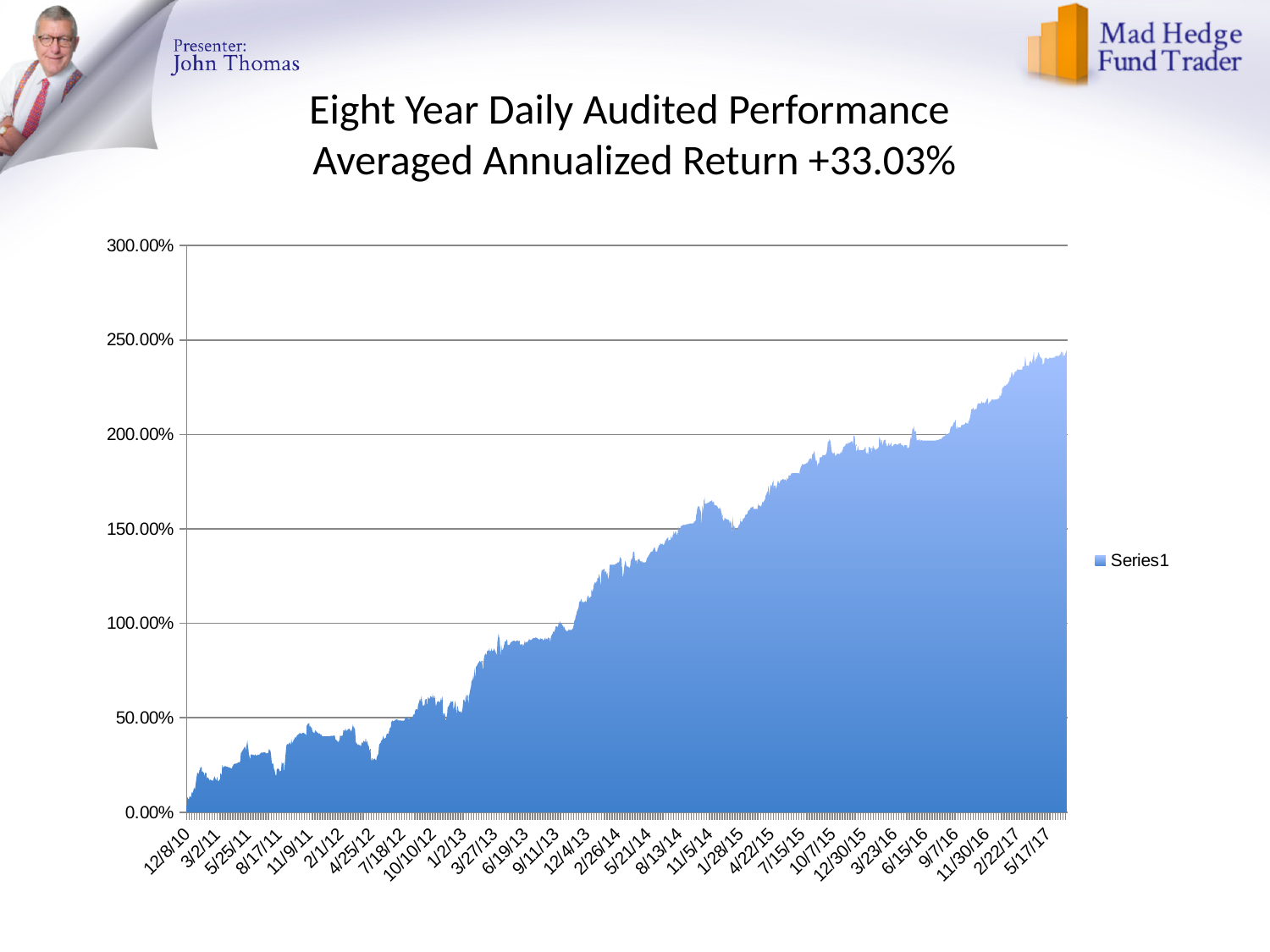
Is the value at 11/5/14 greater or less than 150.00%? greater What is the name of the series shown in the legend? Series1 Is the value at 10/7/15 greater or less than 200.00%? less Is the value at 5/17/17 greater or less than 200.00%? greater What kind of chart is shown on the slide? area chart How many series does the legend list? 1 Do the values generally rise or fall from left to right along the x axis? rise What averaged annualized return is stated in the chart title? +33.03% Which is larger, the value at 5/17/17 or the value at 12/8/10? 5/17/17